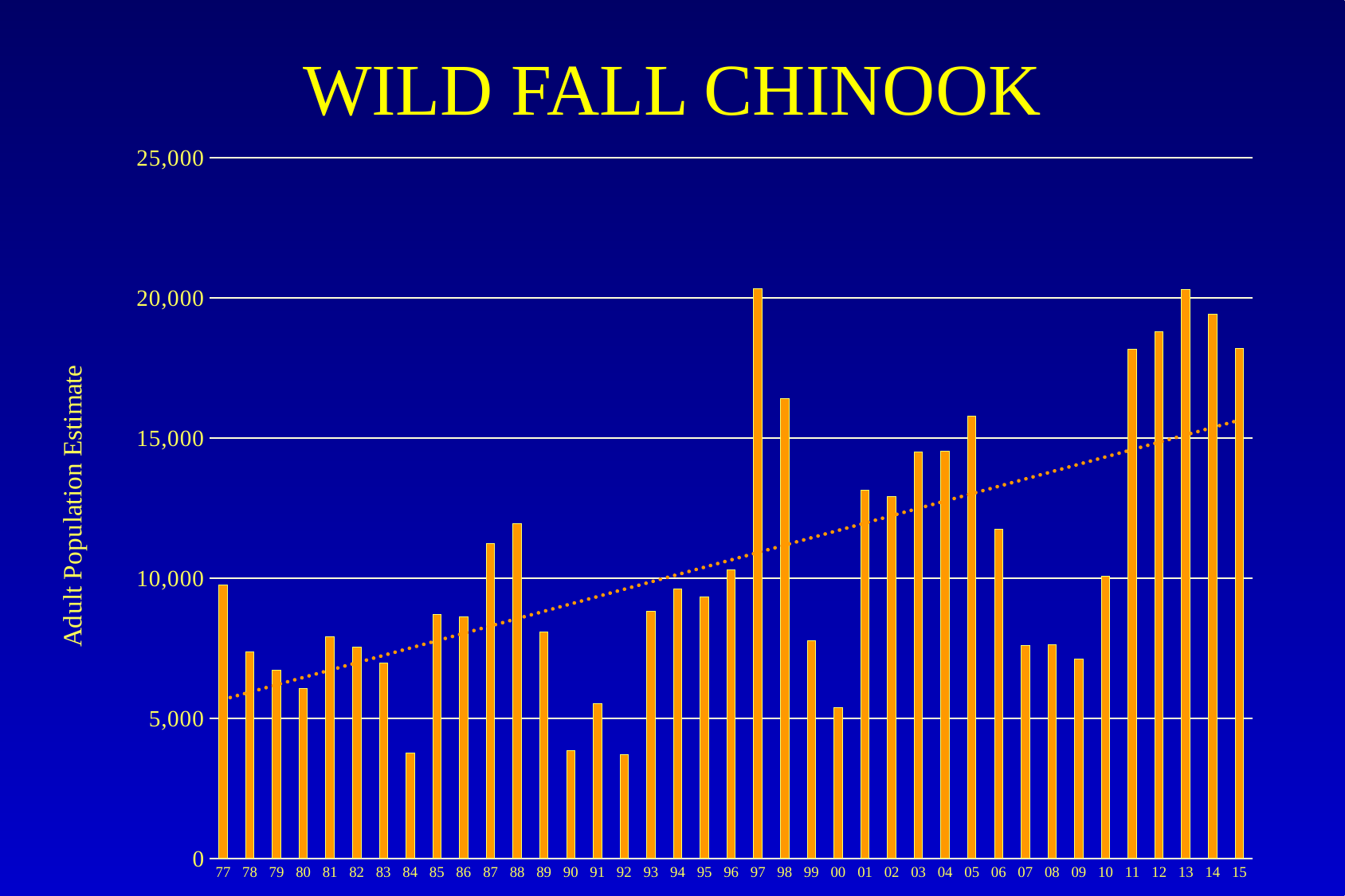
Is the value for 09 greater or less than 10,000? less Is the value for 11 greater or less than 15,000? greater What kind of chart is shown on the slide? bar chart Which year has the larger value, 98 or 99? 98 Is the value for 97 greater or less than 20,000? greater Does the dotted trend line rise or fall from 77 to 15? rise Which year has the larger value, 84 or 85? 85 What is the label on the vertical axis? Adult Population Estimate What is the title of the chart? WILD FALL CHINOOK How many years (bars) are plotted on the chart? 39